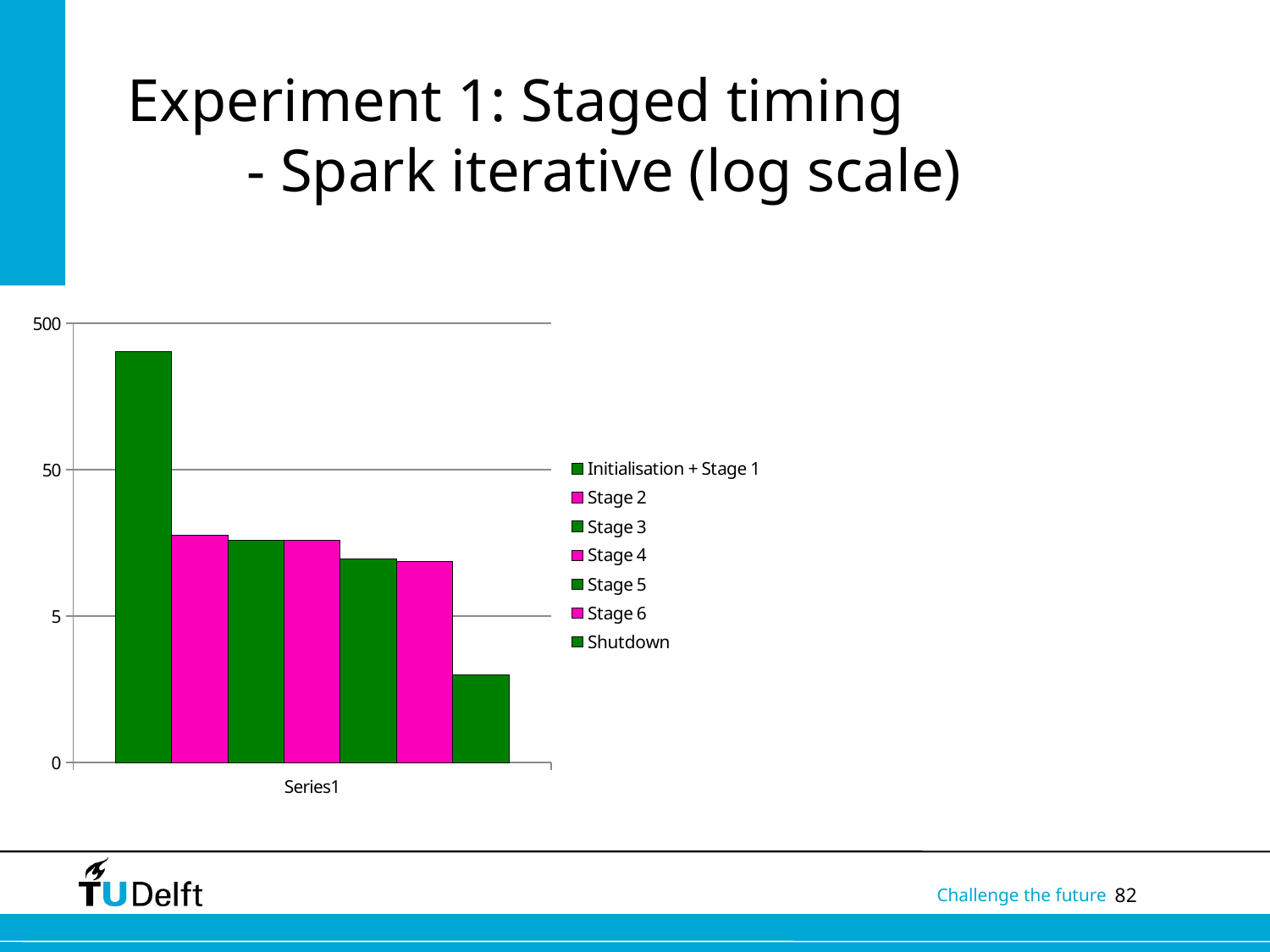
Which series has the highest bar? Initialisation + Stage 1 Which is larger, the value for Initialisation + Stage 1 or the value for Shutdown? Initialisation + Stage 1 Is the value for Stage 5 greater or less than 5? greater Is the value for Shutdown greater or less than 5? less Which is larger, the value for Stage 2 or the value for Stage 5? Stage 2 Which series has the lowest bar? Shutdown How many series does the legend list? 7 Is the value for Stage 2 greater or less than 50? less How many bars are plotted in the chart? 7 What kind of chart is shown on the slide? bar chart What is the category label shown on the x axis? Series1